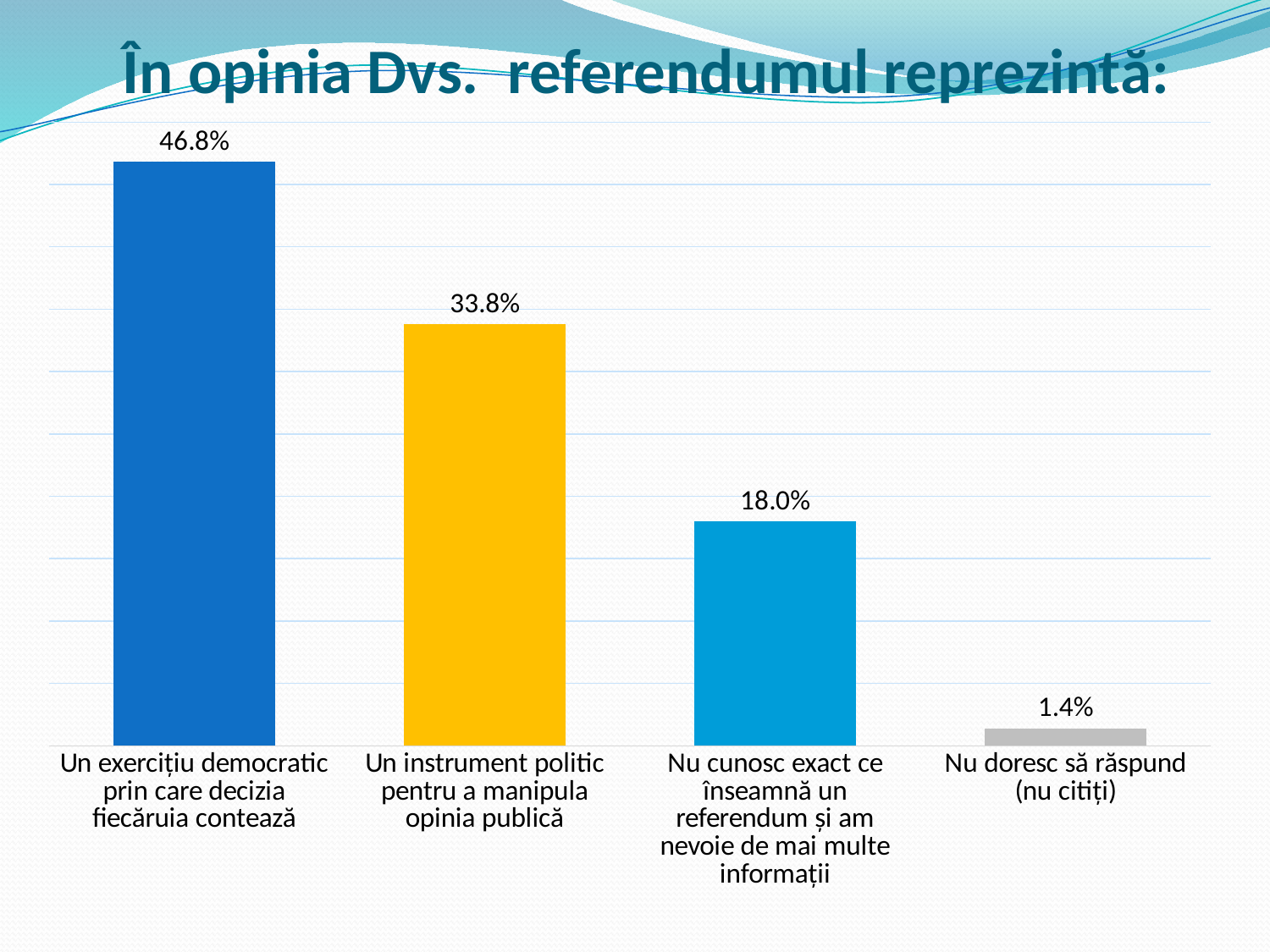
What percentage is shown for 'Nu cunosc exact ce înseamnă un referendum și am nevoie de mai multe informații'? 18.0% What is the difference between the values for 'Un instrument politic pentru a manipula opinia publică' and 'Nu cunosc exact ce înseamnă un referendum și am nevoie de mai multe informații'? 15.8 percentage points What is the value for 'Nu doresc să răspund (nu citiți)'? 1.4% What is the difference in percentage points between 'Un exercițiu democratic prin care decizia fiecăruia contează' and 'Un instrument politic pentru a manipula opinia publică'? 13.0 percentage points How many categories are shown in the chart? 4 What type of chart is shown on the slide? Bar chart What is the title of the slide? În opinia Dvs. referendumul reprezintă: What percentage of respondents said the referendum represents 'Un exercițiu democratic prin care decizia fiecăruia contează'? 46.8% Which is larger: the value for 'Un instrument politic pentru a manipula opinia publică' or for 'Nu cunosc exact ce înseamnă un referendum și am nevoie de mai multe informații'? Un instrument politic pentru a manipula opinia publică Which category has the highest value? Un exercițiu democratic prin care decizia fiecăruia contează Which category has the lowest value? Nu doresc să răspund (nu citiți) What is the value shown for 'Un instrument politic pentru a manipula opinia publică'? 33.8%